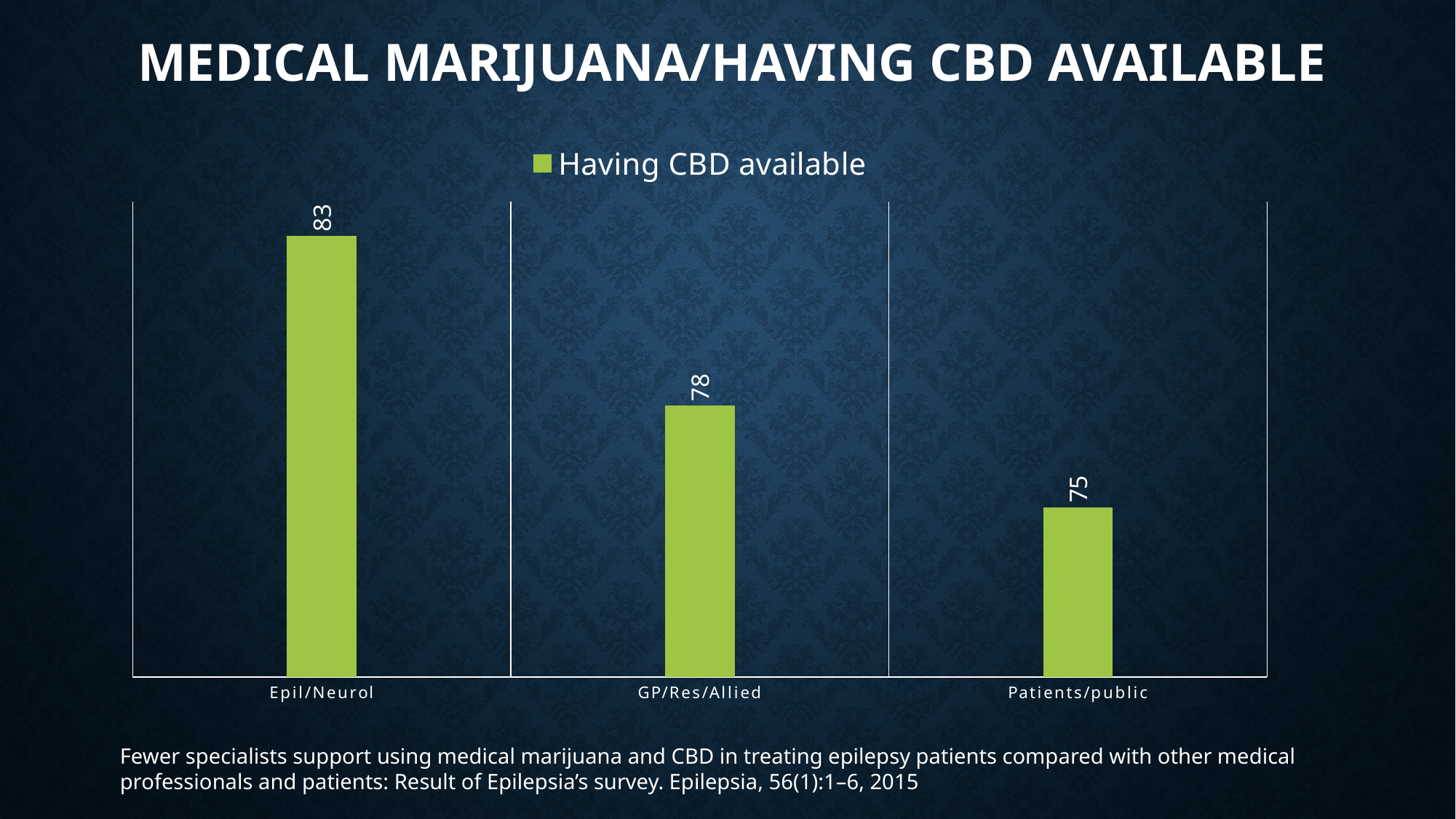
What is the value for Epil/Neurol? 83 What is the value for GP/Res/Allied? 78 What is the value for Patients/public? 75 What kind of chart is shown on the slide? Bar chart How many series does the legend list? 1 What is the difference between the values for Epil/Neurol and Patients/public? 8 Which is larger, the value for GP/Res/Allied or the value for Patients/public? GP/Res/Allied What is the difference between the values for Epil/Neurol and GP/Res/Allied? 5 Which category has the lowest value? Patients/public Which category has the highest value? Epil/Neurol How many categories are shown on the x axis? 3 Do the values rise or fall from left to right along the x axis? Fall